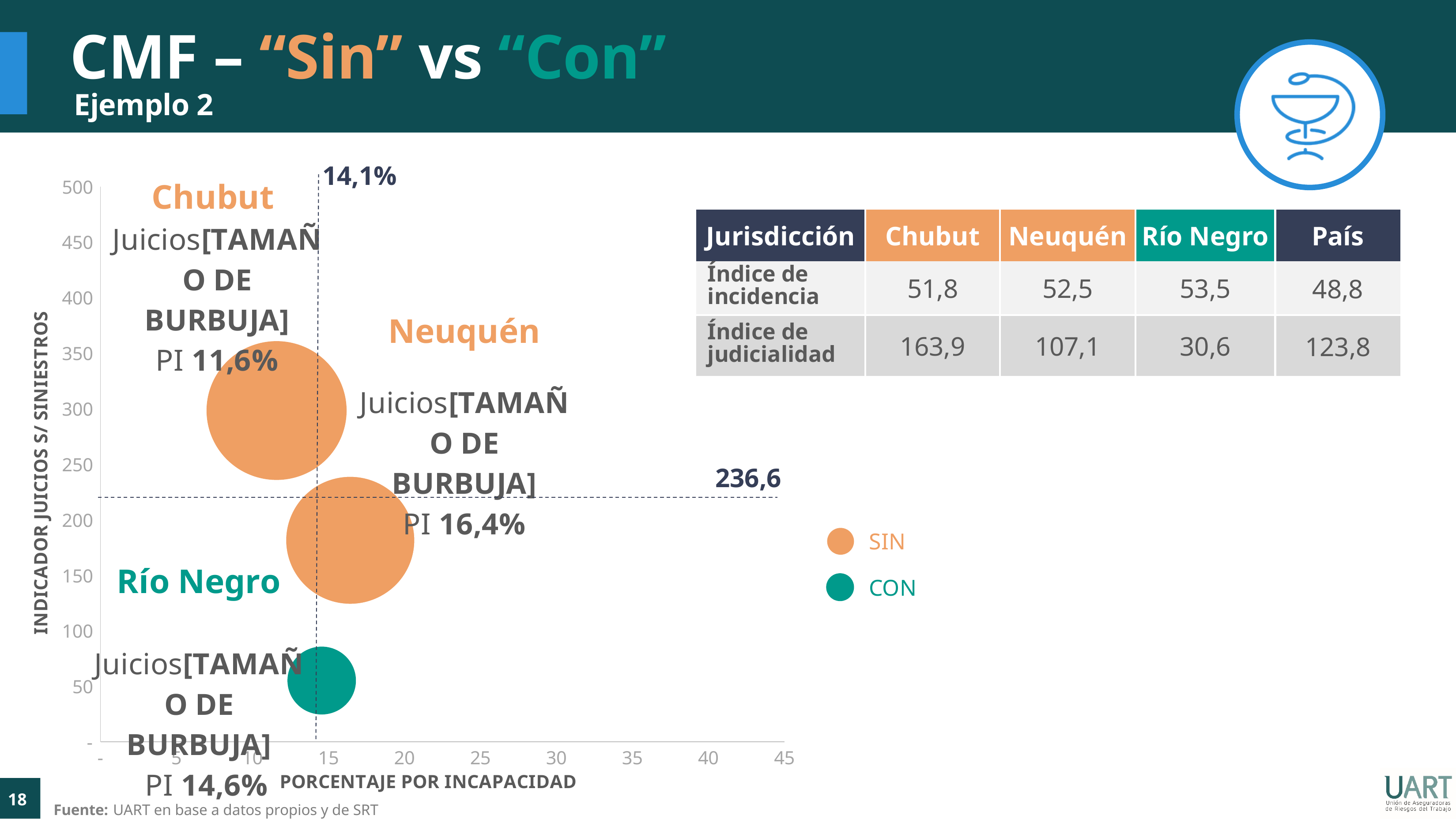
What kind of chart is shown on the slide? bubble chart What is the PI value shown for Neuquén? 16,4% What is the difference between the PI values of Neuquén and Chubut? 4,8% How many series does the chart legend list? 2 What is the PI (porcentaje por incapacidad) value shown for Chubut? 11,6% Which jurisdiction is plotted in the CON series (green bubble)? Río Negro Is the indicador juicios s/ siniestros value for Río Negro greater or less than 100? less What is the PI value shown for Río Negro? 14,6% How many jurisdictions are plotted as bubbles in the chart? 3 Which jurisdiction has the lowest PI value in the chart? Chubut Which jurisdiction has the highest PI value in the chart? Neuquén Is the indicador juicios s/ siniestros value for Chubut greater or less than 250? greater